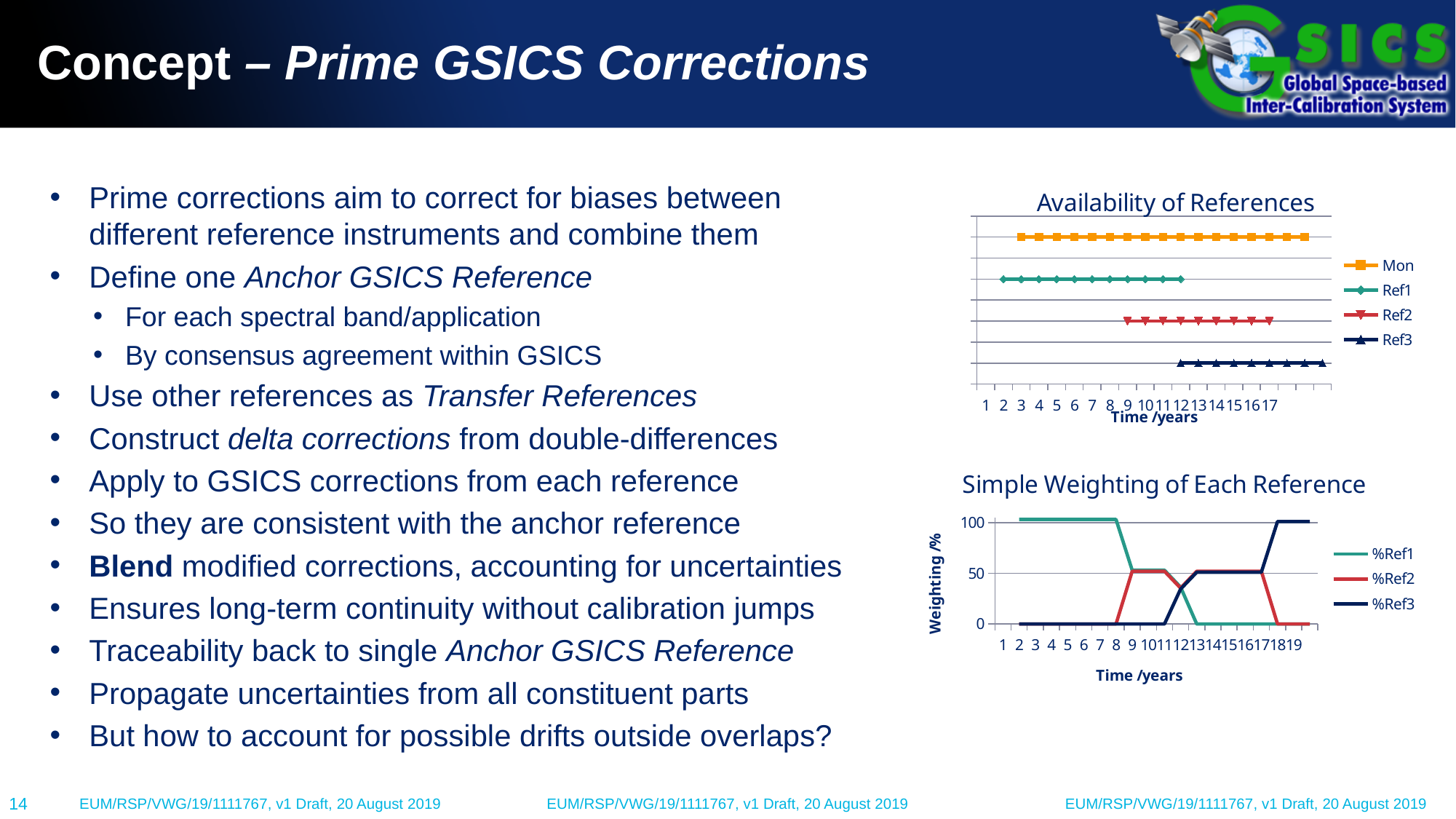
In the 'Simple Weighting of Each Reference' chart, which series is higher at year 18: %Ref1 or %Ref3? %Ref3 What is the x-axis title of the 'Simple Weighting of Each Reference' chart? Time /years In the 'Availability of References' chart, which series extends furthest to the right along the time axis? Ref3 In the 'Simple Weighting of Each Reference' chart, is the value for %Ref2 at year 4 greater or less than 50? less In the 'Simple Weighting of Each Reference' chart, is the value for %Ref1 at year 4 greater or less than 50? greater How many series does the legend of the 'Simple Weighting of Each Reference' chart list? 3 In the 'Simple Weighting of Each Reference' chart, does the %Ref3 series rise or fall along the x axis? Rise How many series does the legend of the 'Availability of References' chart list? 4 In the 'Simple Weighting of Each Reference' chart, is the value for %Ref3 at year 18 greater or less than 50? greater In the 'Simple Weighting of Each Reference' chart, does the %Ref1 series rise or fall along the x axis? Fall What is the y-axis title of the 'Simple Weighting of Each Reference' chart? Weighting /% What kind of chart is the 'Simple Weighting of Each Reference' chart? Line chart